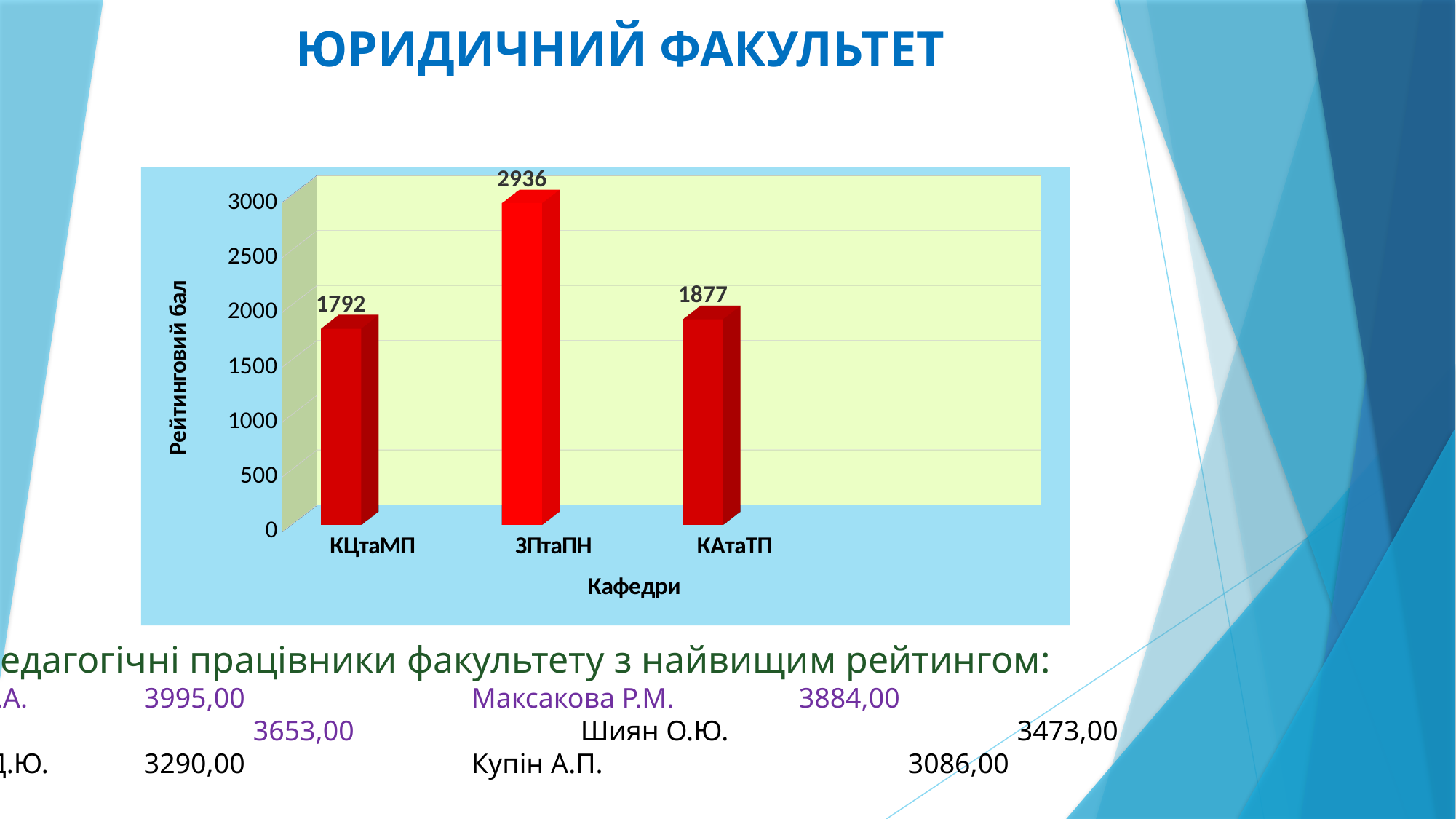
What is the difference between the rating scores of КАтаТП and КЦтаМП? 85 Is the value for ЗПтаПН greater or less than 2500? greater What is the difference between the rating scores of ЗПтаПН and КАтаТП? 1059 What is the label of the x axis of the chart? Кафедри What is the rating score for ЗПтаПН? 2936 How many departments are shown on the chart? 3 Which has a higher rating score, КЦтаМП or ЗПтаПН? ЗПтаПН Which department (кафедра) has the highest rating score? ЗПтаПН What kind of chart is shown on the slide? bar chart What is the rating score for КАтаТП? 1877 What is the rating score (Рейтинговий бал) for КЦтаМП? 1792 Which department has the lowest rating score? КЦтаМП